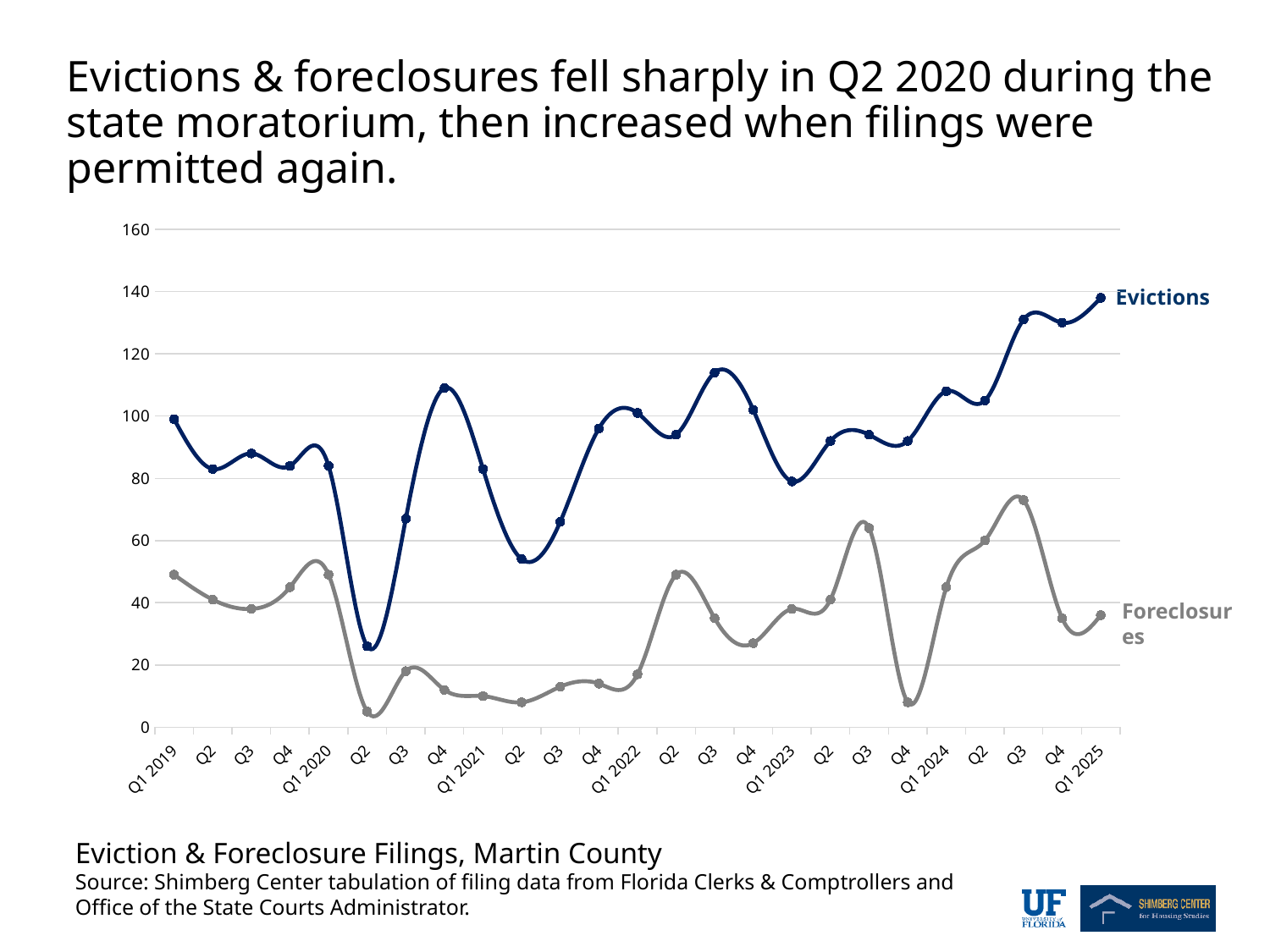
In which quarter is the Evictions line at its highest? Q1 2025 In which quarter is the Evictions line at its lowest? Q2 2020 Is the value for Evictions in Q1 2025 greater or less than 120? greater How many series are plotted on the chart? 2 What kind of chart is shown on the slide? line chart What is the chart's title shown below the plot? Eviction & Foreclosure Filings, Martin County Is the value for Foreclosures in Q3 2024 greater or less than 60? greater Is the value for Evictions in Q2 2020 greater or less than 40? less In Q1 2025, which series has the larger value, Evictions or Foreclosures? Evictions How many quarterly data points does each line have, from Q1 2019 to Q1 2025? 25